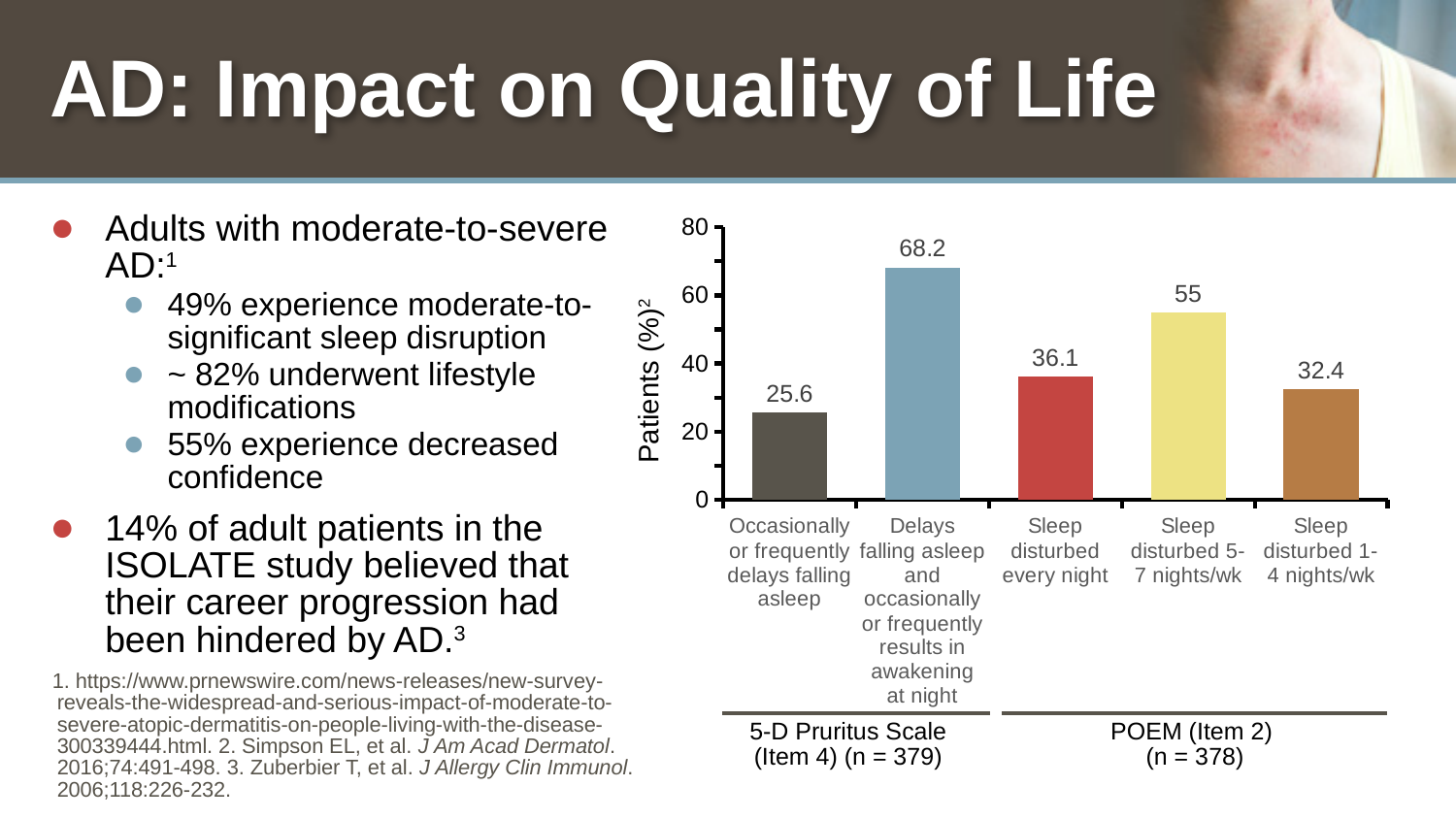
What type of chart is shown on the slide? bar chart What is the sample size (n) for the POEM (Item 2) group? 378 Which category has the lowest percentage of patients? Occasionally or frequently delays falling asleep What is the value for 'Sleep disturbed every night'? 36.1 What is the difference between the values for 'Sleep disturbed 5-7 nights/wk' and 'Sleep disturbed 1-4 nights/wk'? 22.6 Which is larger: the value for 'Sleep disturbed every night' or 'Occasionally or frequently delays falling asleep'? Sleep disturbed every night What is the label of the y-axis? Patients (%) What is the value for 'Sleep disturbed 1-4 nights/wk'? 32.4 How many bars are shown in the chart? 5 What percentage of patients report that AD delays falling asleep and occasionally or frequently results in awakening at night? 68.2 Which category has the highest percentage of patients? Delays falling asleep and occasionally or frequently results in awakening at night Is the value for 'Sleep disturbed 5-7 nights/wk' greater or less than 40? greater